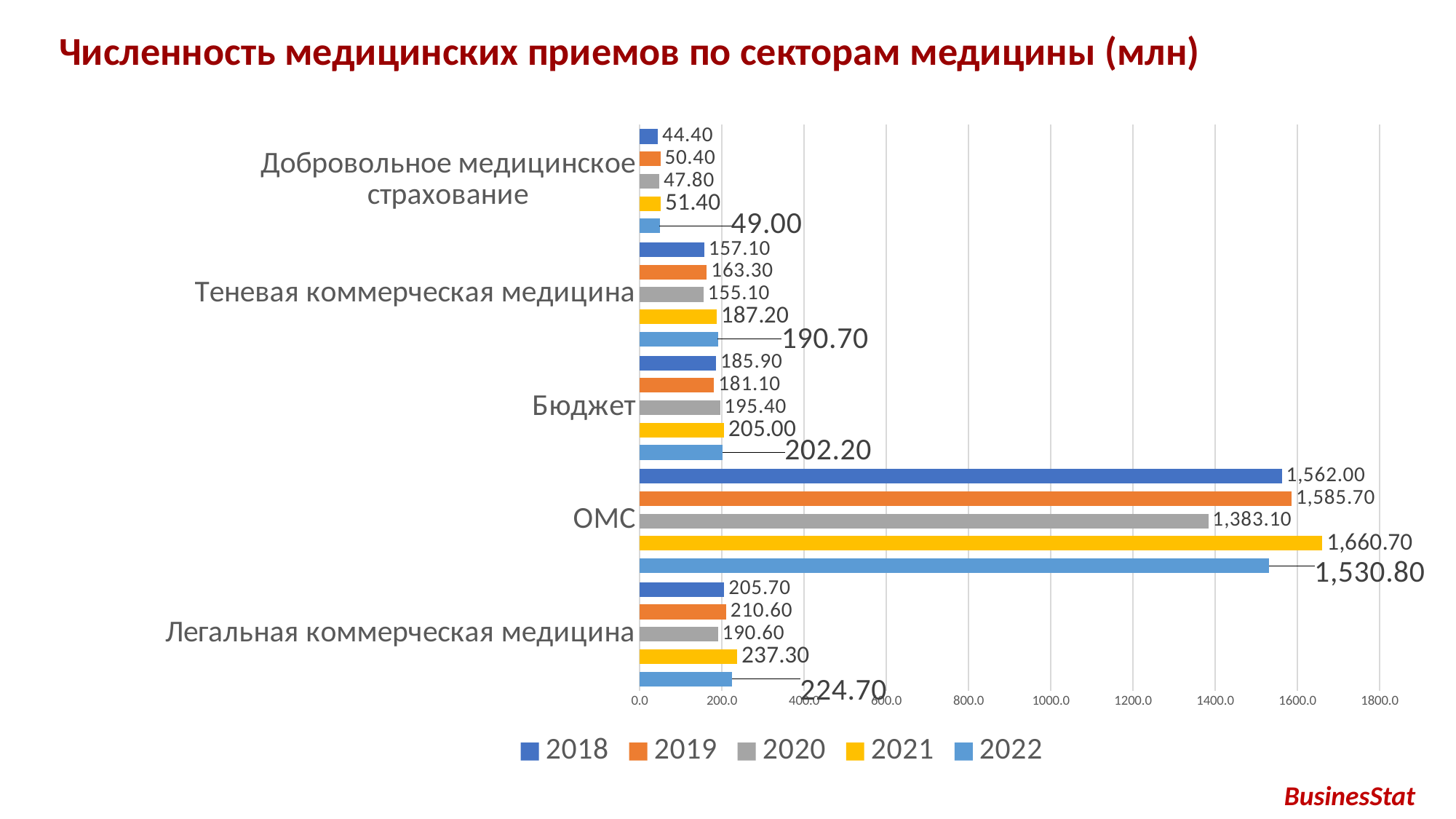
Which is larger in 2021: Бюджет or Легальная коммерческая медицина? Легальная коммерческая медицина What is the value for Легальная коммерческая медицина in 2022? 224.70 What is the value for Бюджет in 2020? 195.40 How many categories are shown on the chart? 5 What type of chart is shown on the slide? Bar chart Which category has the lowest value in 2018? Добровольное медицинское страхование In which year was the value for ОМС the highest? 2021 How many series does the legend list? 5 What is the difference between the 2021 and 2020 values for ОМС? 277.60 What is the value for Добровольное медицинское страхование in 2019? 50.40 What is the value for ОМС in 2021? 1,660.70 Which category has the highest value in 2022? ОМС